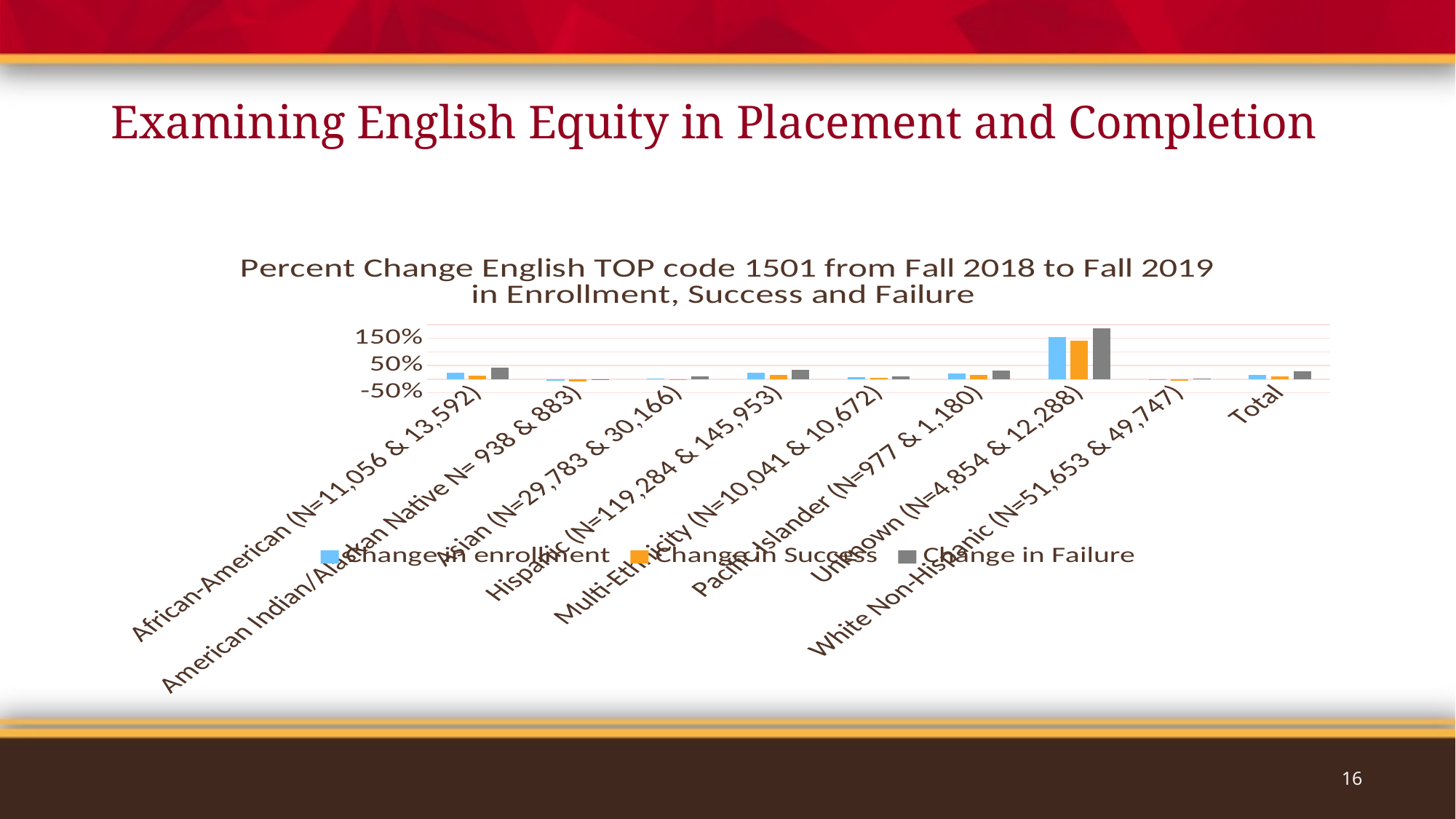
How many series does the legend list? 3 Which category has the highest Change in enrollment? Unknown (N=4,854 & 12,288) Is the Change in Success for Unknown (N=4,854 & 12,288) greater or less than 50%? greater Which is larger for Unknown (N=4,854 & 12,288): Change in Failure or Change in Success? Change in Failure Which category has the highest Change in Failure? Unknown (N=4,854 & 12,288) Which category has the highest Change in Success? Unknown (N=4,854 & 12,288) What is the title of the chart? Percent Change English TOP code 1501 from Fall 2018 to Fall 2019 in Enrollment, Success and Failure Which series is shown in orange in the legend? Change in Success Is the Change in Failure for Hispanic (N=119,284 & 145,953) greater or less than 50%? less Is the Change in enrollment for Unknown (N=4,854 & 12,288) greater or less than 50%? greater How many categories are shown along the x axis? 9 What kind of chart is shown on the slide? bar chart